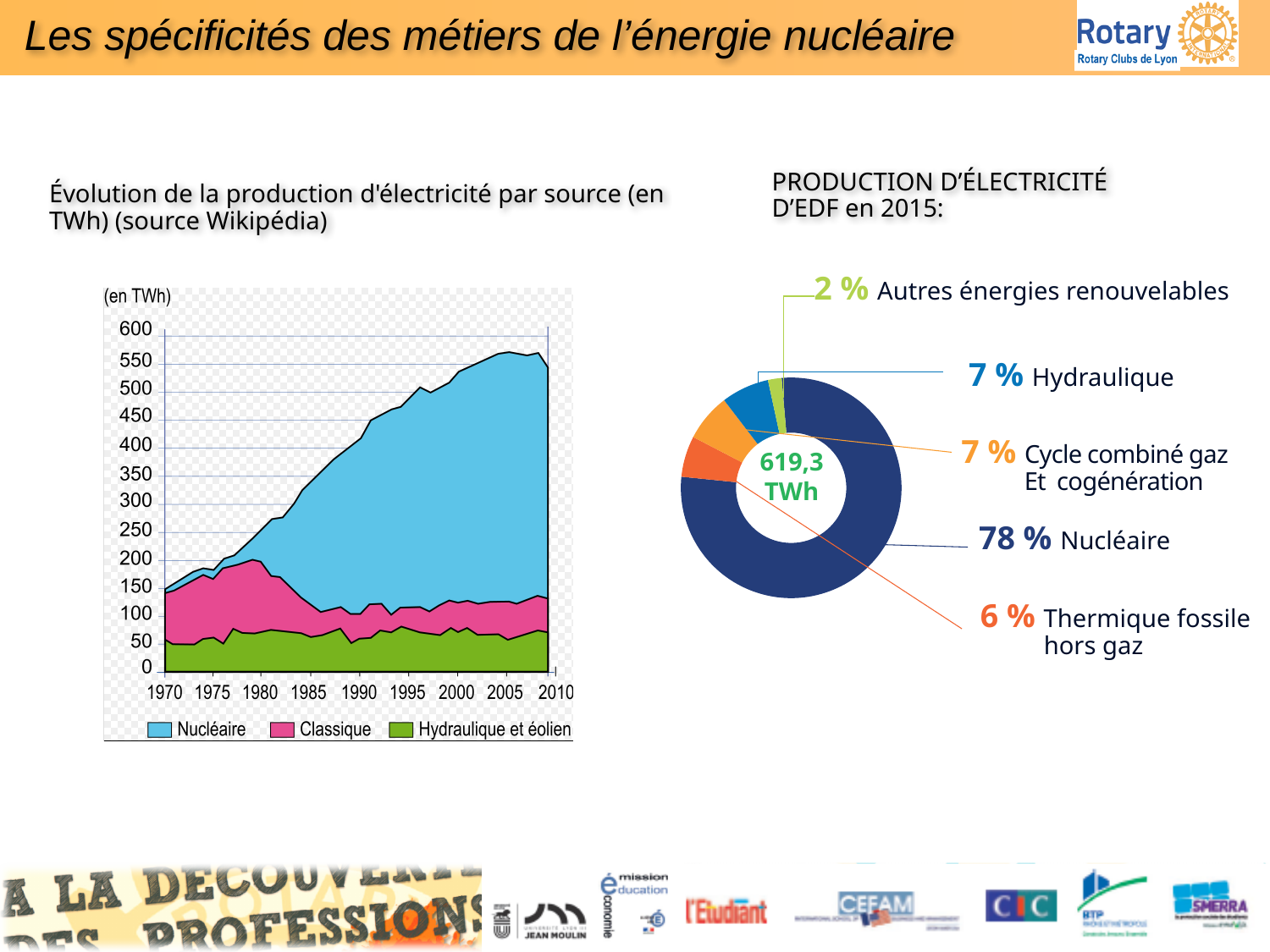
On the donut chart 'Production d'électricité d'EDF en 2015', how many sources are shown? 5 On the left chart 'Évolution de la production d'électricité par source', is the total production in 2005 greater or less than 500 TWh? greater On the donut chart 'Production d'électricité d'EDF en 2015', what share is Thermique fossile hors gaz? 6 % On the left chart 'Évolution de la production d'électricité par source', how many series does the legend list? 3 On the donut chart 'Production d'électricité d'EDF en 2015', what share is Autres énergies renouvelables? 2 % On the left chart 'Évolution de la production d'électricité par source', does the Nucléaire production rise or fall between 1980 and 2005? rise On the donut chart 'Production d'électricité d'EDF en 2015', what total production is shown in the centre? 619,3 TWh On the donut chart 'Production d'électricité d'EDF en 2015', which source has the smallest share? Autres énergies renouvelables On the donut chart 'Production d'électricité d'EDF en 2015', which source has the largest share? Nucléaire On the donut chart 'Production d'électricité d'EDF en 2015', what share is Nucléaire? 78 % On the donut chart 'Production d'électricité d'EDF en 2015', what is the difference in percentage points between Nucléaire and Thermique fossile hors gaz? 72 On the donut chart 'Production d'électricité d'EDF en 2015', which is larger: Hydraulique or Thermique fossile hors gaz? Hydraulique